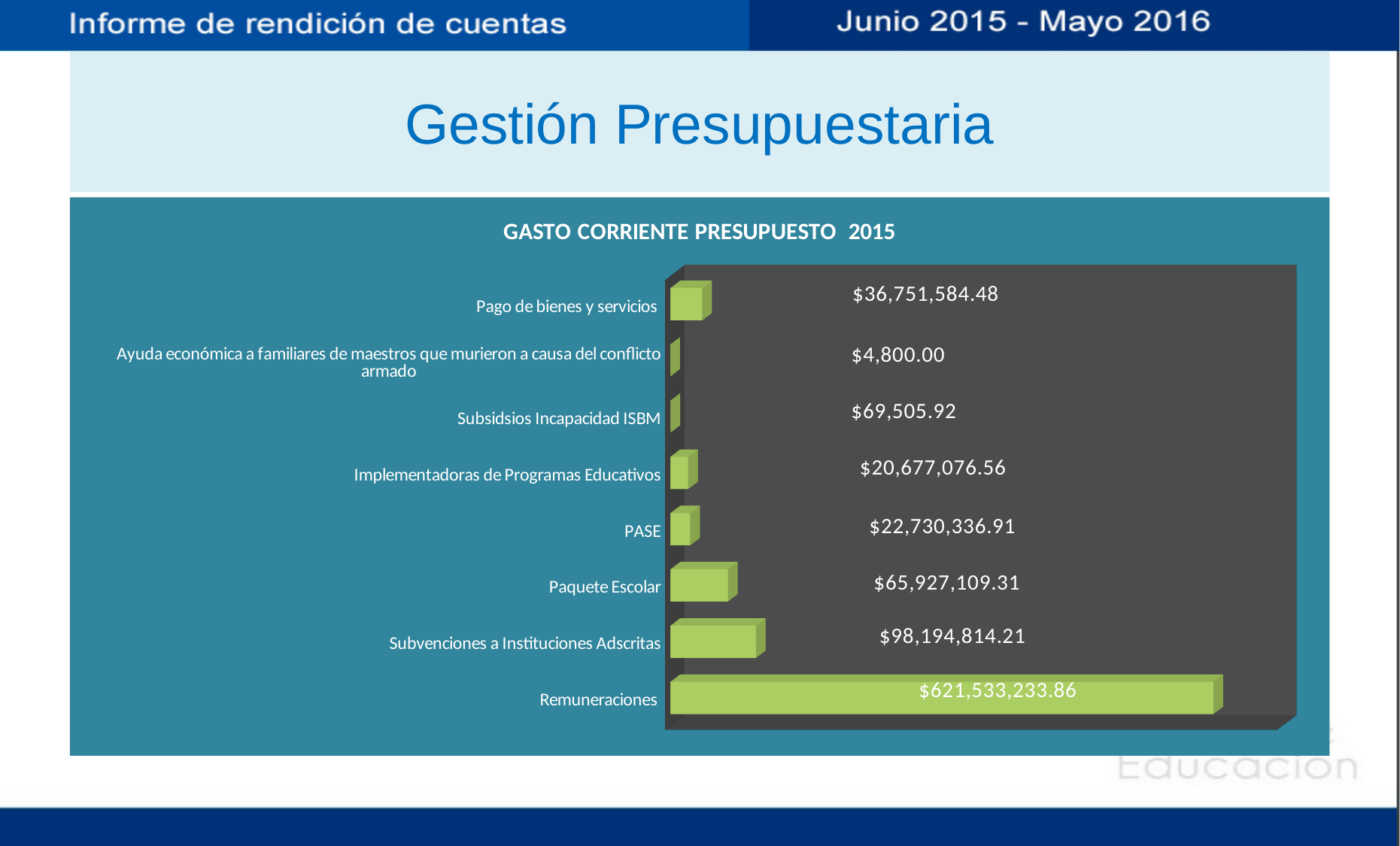
What is the value for Remuneraciones? $621,533,233.86 What is the title of the chart? GASTO CORRIENTE PRESUPUESTO 2015 How many categories are shown in the chart? 8 What is the difference between Paquete Escolar and Pago de bienes y servicios? $29,175,524.83 What kind of chart is shown on the slide? Bar chart Which category has the lowest value? Ayuda económica a familiares de maestros que murieron a causa del conflicto armado What is the difference between Remuneraciones and Subvenciones a Instituciones Adscritas? $523,338,419.65 What is the value for PASE? $22,730,336.91 Which category has the highest value? Remuneraciones What is the value for Paquete Escolar? $65,927,109.31 What is the value for Subsidsios Incapacidad ISBM? $69,505.92 Which is larger, Paquete Escolar or Pago de bienes y servicios? Paquete Escolar